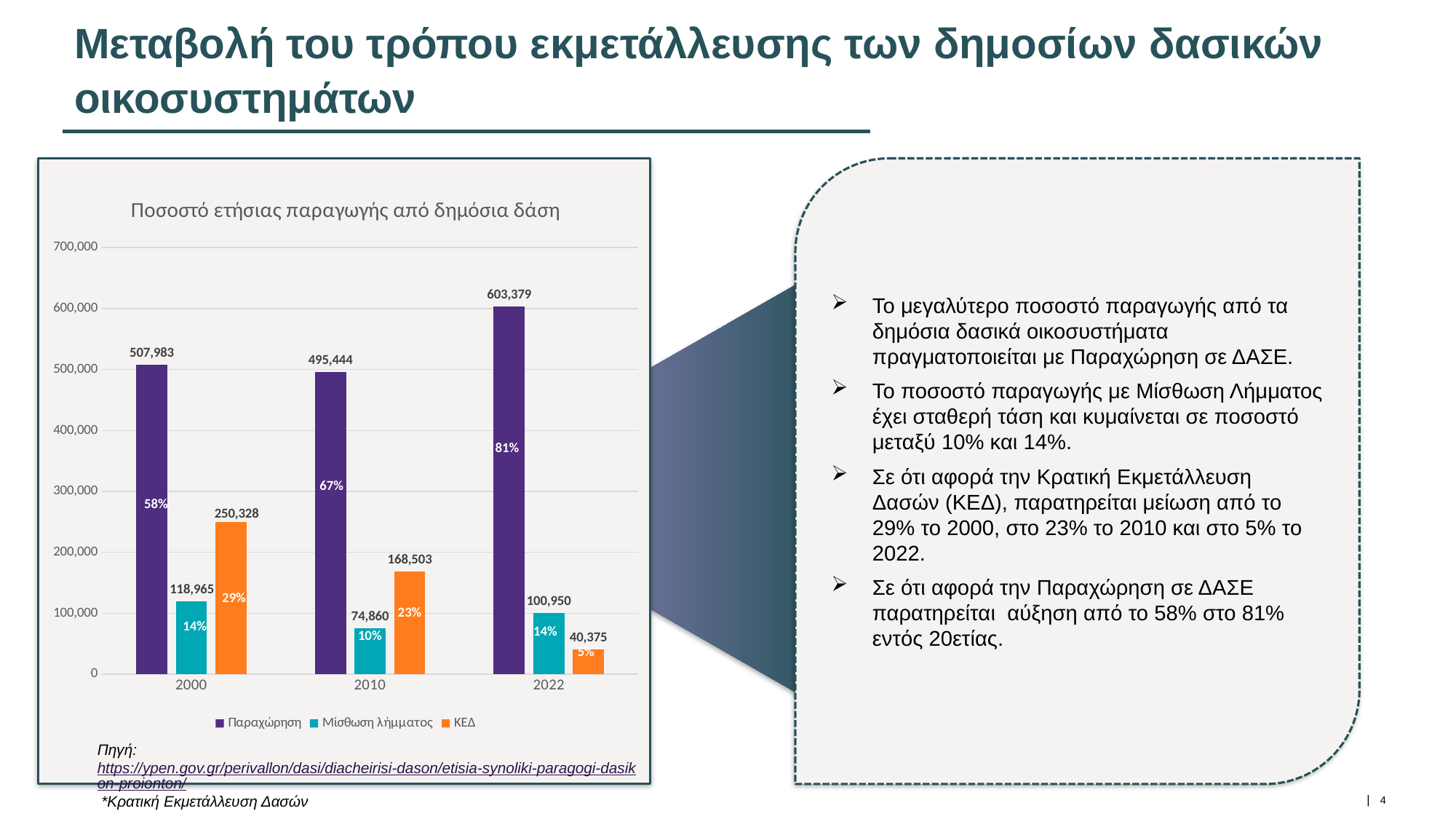
How many series does the legend list? 3 In which year is the Παραχώρηση value highest? 2022 Which is larger in 2000: the Μίσθωση λήμματος value or the ΚΕΔ value? ΚΕΔ What is the difference between the Παραχώρηση values for 2022 and 2000? 95,396 What percentage label is shown on the Παραχώρηση bar for 2010? 67% In which year is the ΚΕΔ value lowest? 2022 What is the value for Παραχώρηση in 2022? 603,379 How many years are shown on the x axis? 3 What is the value for ΚΕΔ in 2000? 250,328 What type of chart is shown on the slide? Bar chart What is the value for Μίσθωση λήμματος in 2010? 74,860 Does the ΚΕΔ value rise or fall from 2000 to 2022? Fall